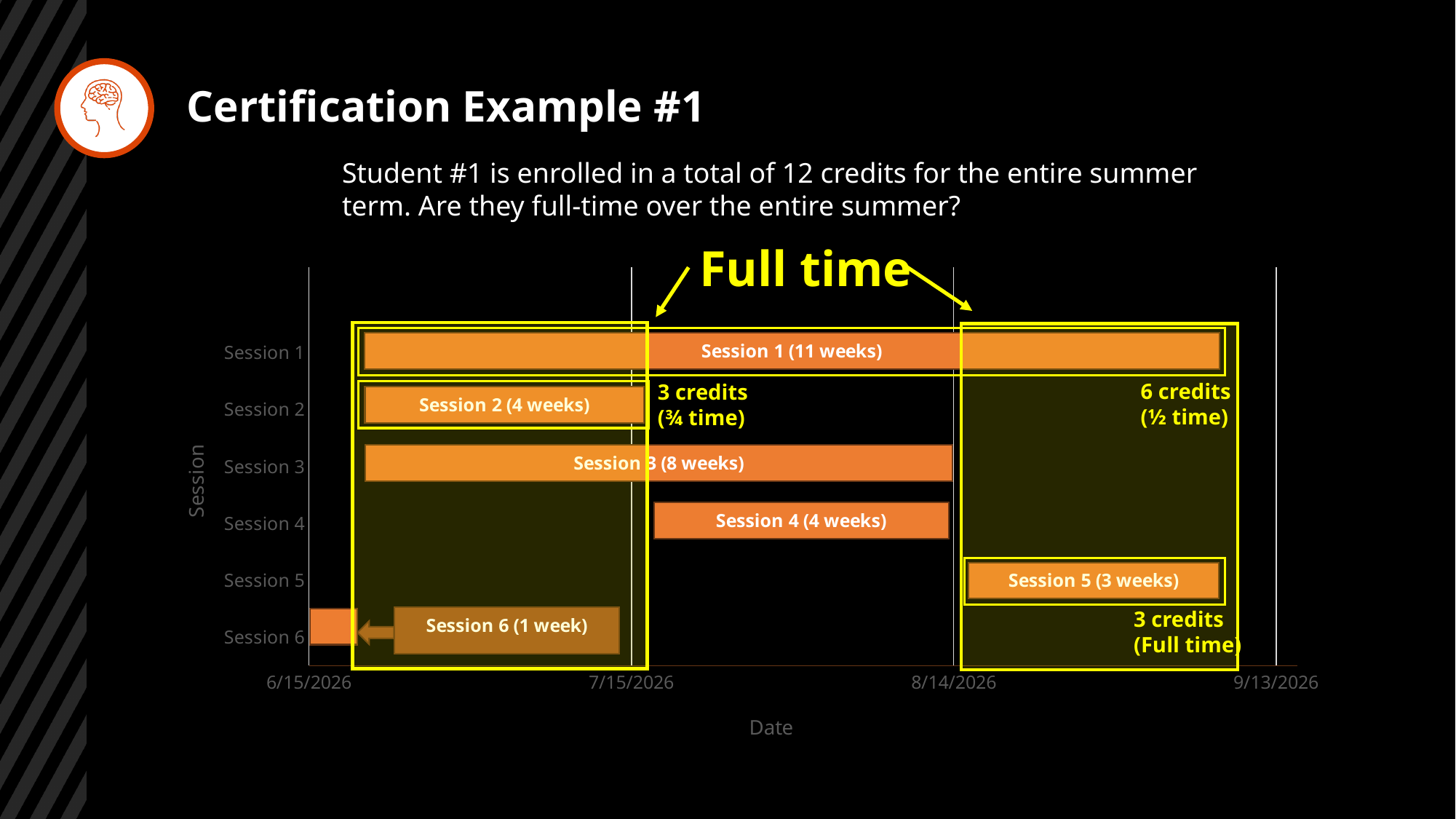
Which is longer, Session 4 or Session 5? Session 4 How many weeks long is Session 1 according to its data label? 11 weeks How many weeks long is Session 5 according to its data label? 3 weeks What kind of chart is shown on the slide? Bar chart How many weeks longer is Session 3 than Session 2? 4 weeks How many weeks long is Session 3 according to its data label? 8 weeks How many weeks longer is Session 1 than Session 3? 3 weeks Which session has the shortest duration in the chart? Session 6 What is the label of the horizontal axis of the chart? Date How long is Session 6 according to its data label? 1 week How many sessions are listed on the vertical axis of the chart? 6 Which session has the longest duration in the chart? Session 1